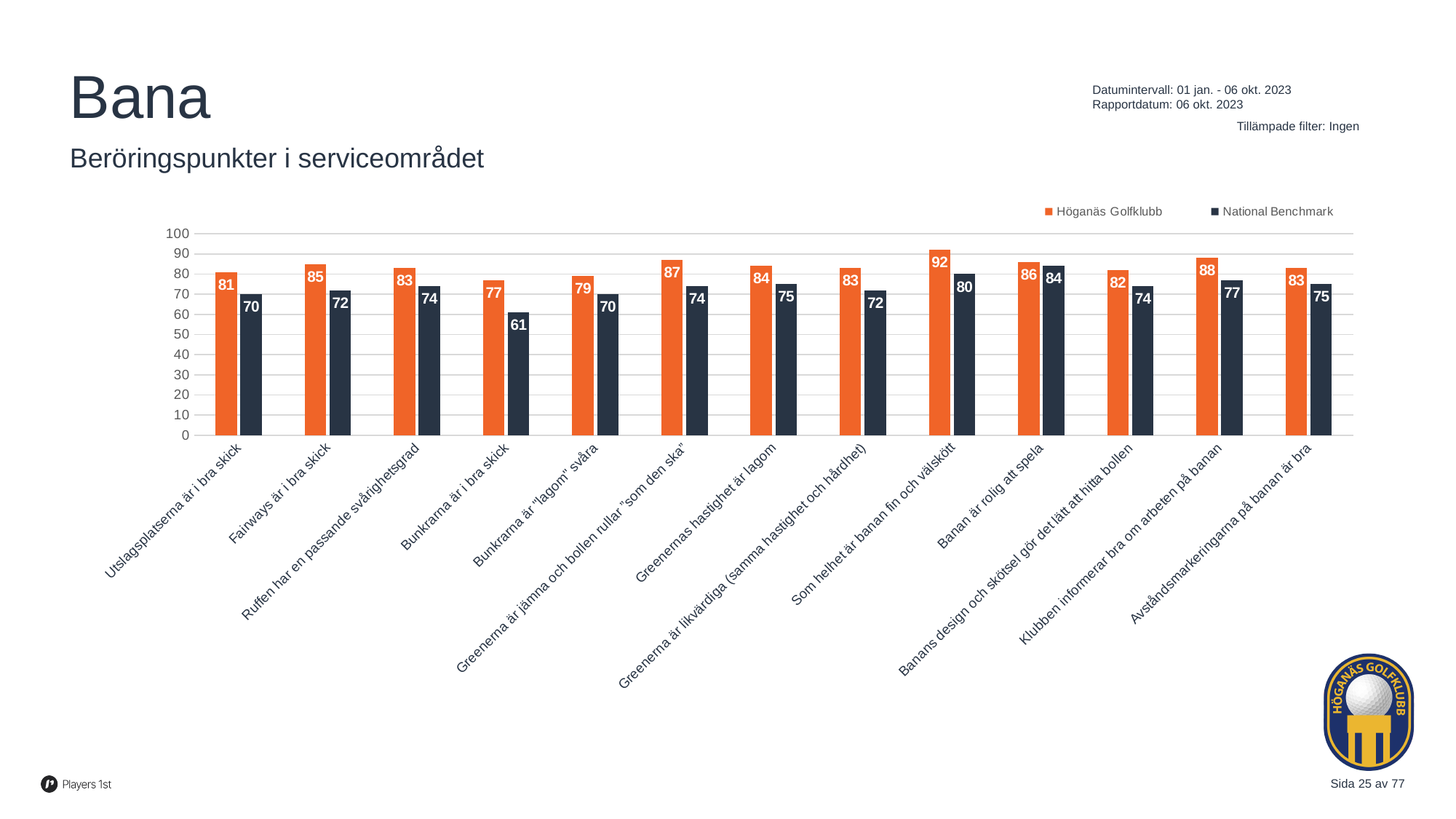
What is the Höganäs Golfklubb value for "Klubben informerar bra om arbeten på banan"? 88 Which series is shown in orange in the legend? Höganäs Golfklubb What kind of chart is shown on the slide? Bar chart Which is larger for "Banan är rolig att spela": the Höganäs Golfklubb value or the National Benchmark value? Höganäs Golfklubb Which category has the highest Höganäs Golfklubb value? Som helhet är banan fin och välskött What is the Höganäs Golfklubb value for "Som helhet är banan fin och välskött"? 92 What is the National Benchmark value for "Bunkrarna är i bra skick"? 61 How many series does the legend list? 2 How many categories are shown on the x axis of the chart? 13 Is the National Benchmark value for "Som helhet är banan fin och välskött" greater or less than 70? greater Which category has the lowest National Benchmark value? Bunkrarna är i bra skick What is the difference between the Höganäs Golfklubb and National Benchmark values for "Bunkrarna är i bra skick"? 16